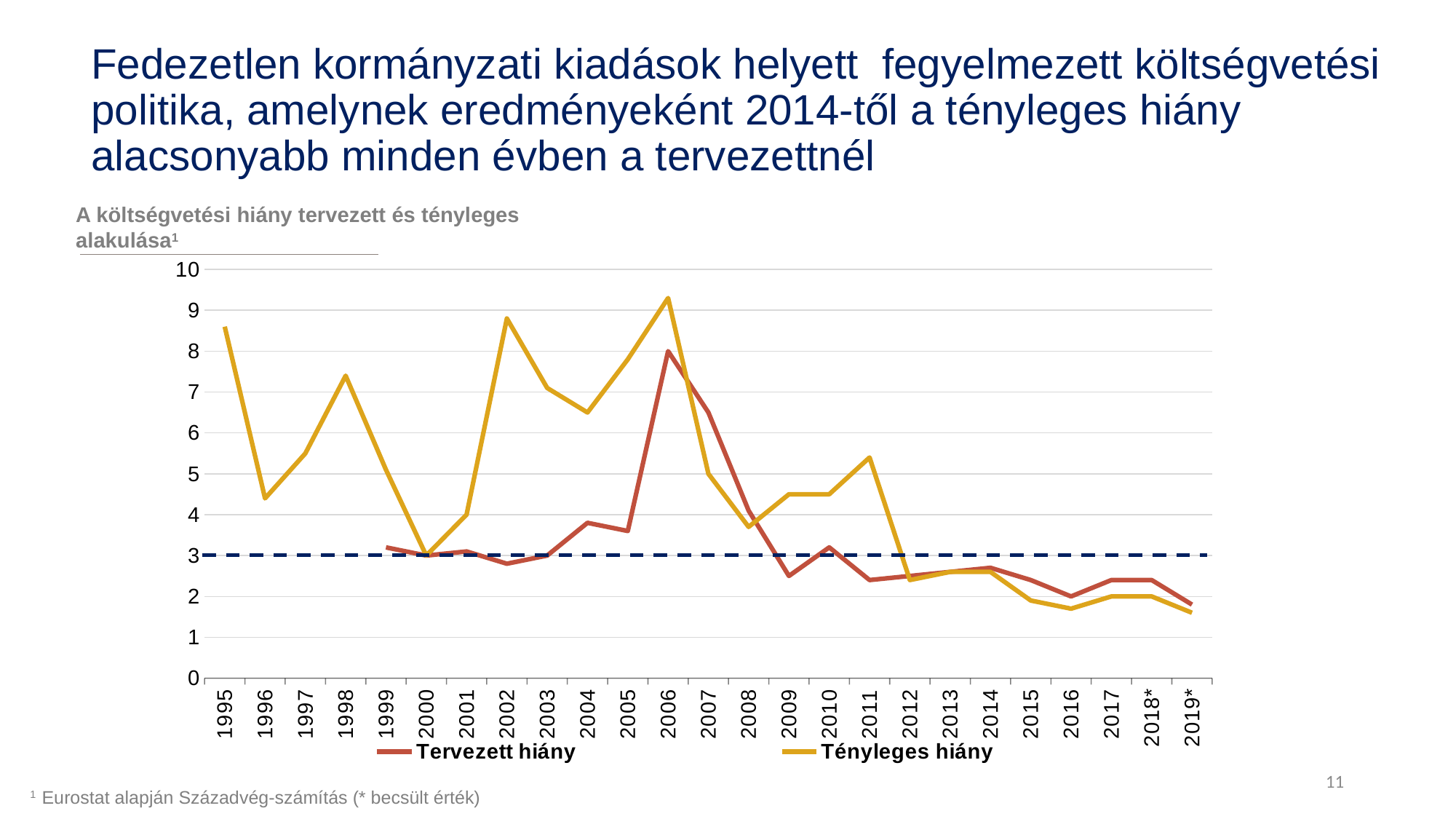
How many years are shown on the x axis? 25 Is the Tényleges hiány value for 1995 greater or less than 8? greater Is the Tervezett hiány value for 2009 greater or less than 3? less In 2010, which series has the larger value, Tervezett hiány or Tényleges hiány? Tényleges hiány Does the Tervezett hiány series rise or fall from 2006 to 2009? fall In 2015, which series has the larger value, Tervezett hiány or Tényleges hiány? Tervezett hiány In which year does the Tervezett hiány series reach its highest value? 2006 Is the Tényleges hiány value for 2011 greater or less than 5? greater What kind of chart is shown on the slide? line chart In which year does the Tényleges hiány series reach its highest value? 2006 How many series does the legend list? 2